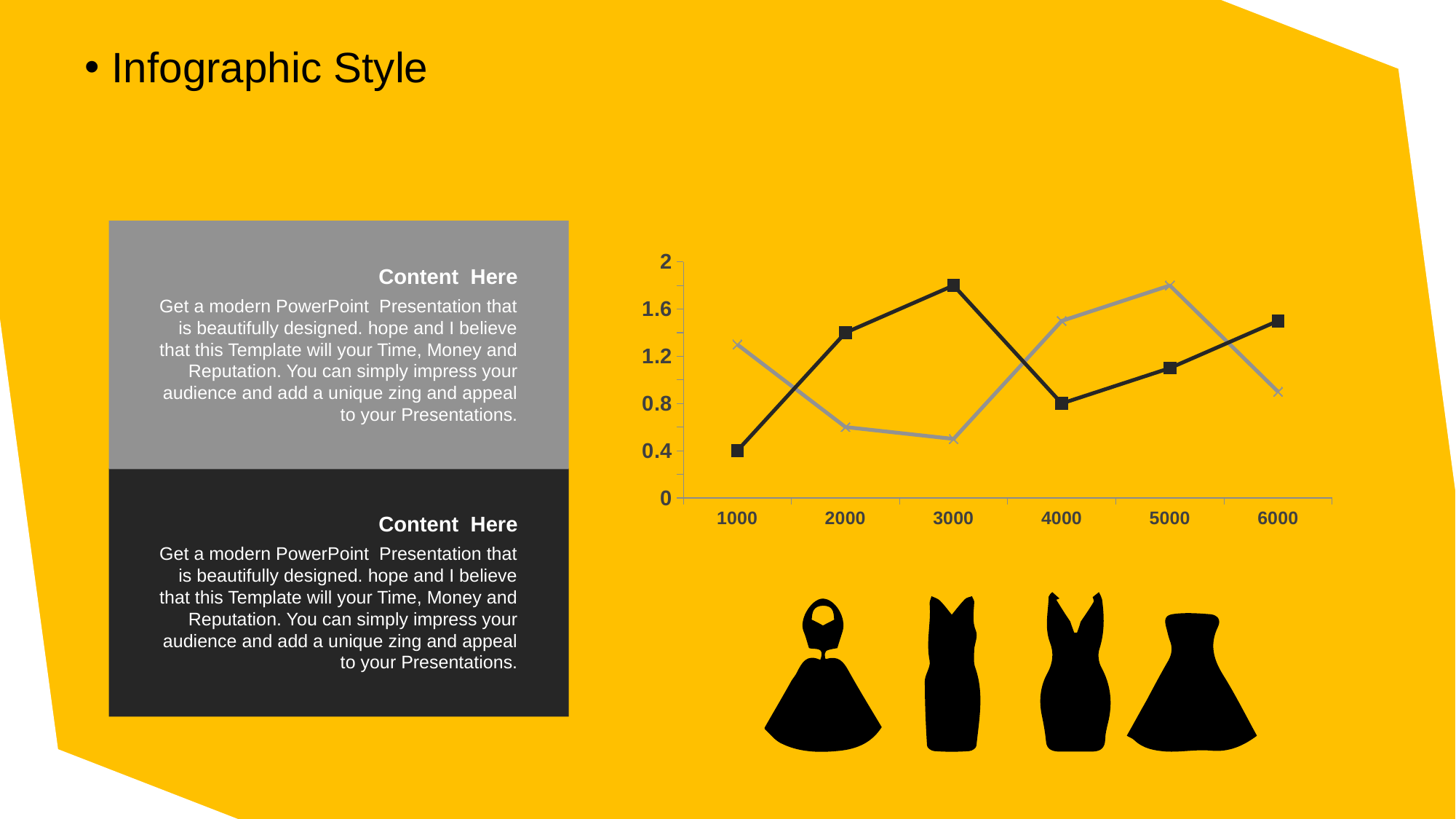
What is the value of the black line at 1000? 0.4 How many points are plotted along the x axis for each line? 6 How many lines are plotted on the chart? 2 What kind of chart is shown on the slide? line chart Is the value of the gray line at 3000 greater or less than 0.8? less Is the value of the black line at 3000 greater or less than 1.6? greater At which x-axis value does the gray line reach its highest point? 5000 Is the value of the gray line at 5000 greater or less than 1.6? greater At which x-axis value does the black line reach its highest point? 3000 At 2000, which line has the higher value, the black line or the gray line? black line At 6000, which line has the higher value, the black line or the gray line? black line What is the value of the black line at 4000? 0.8